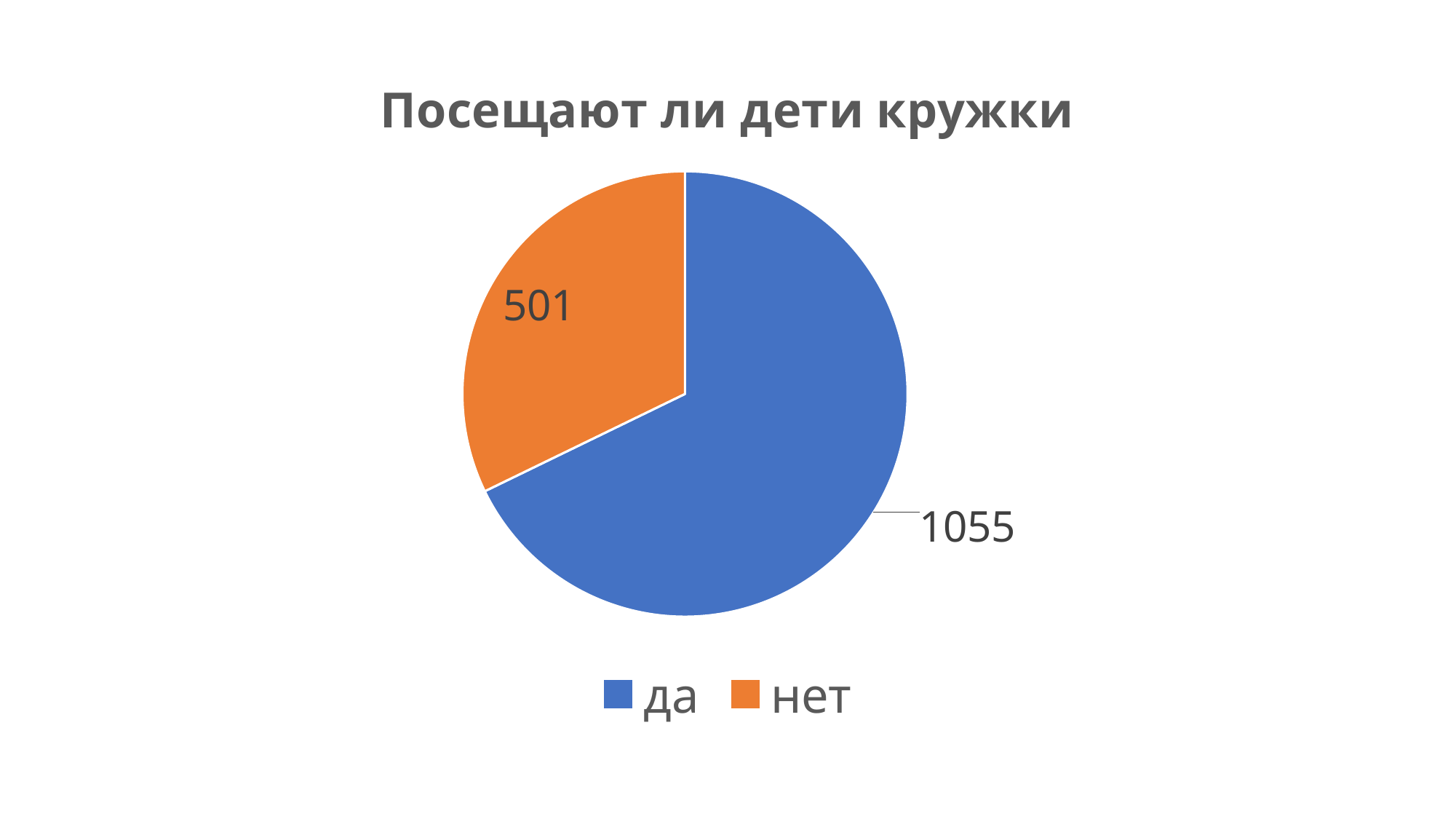
What is the total of all slices in the pie chart? 1556 Which slice is the smallest? нет How many slices does the pie chart have? 2 What is the title of the chart? Посещают ли дети кружки What kind of chart is shown on the slide? pie chart What is the difference between the values for "да" and "нет"? 554 Which is larger, the value for "да" or the value for "нет"? да How many entries does the legend list? 2 What is the value for the "да" slice? 1055 What is the value for the "нет" slice? 501 Which slice is the largest? да